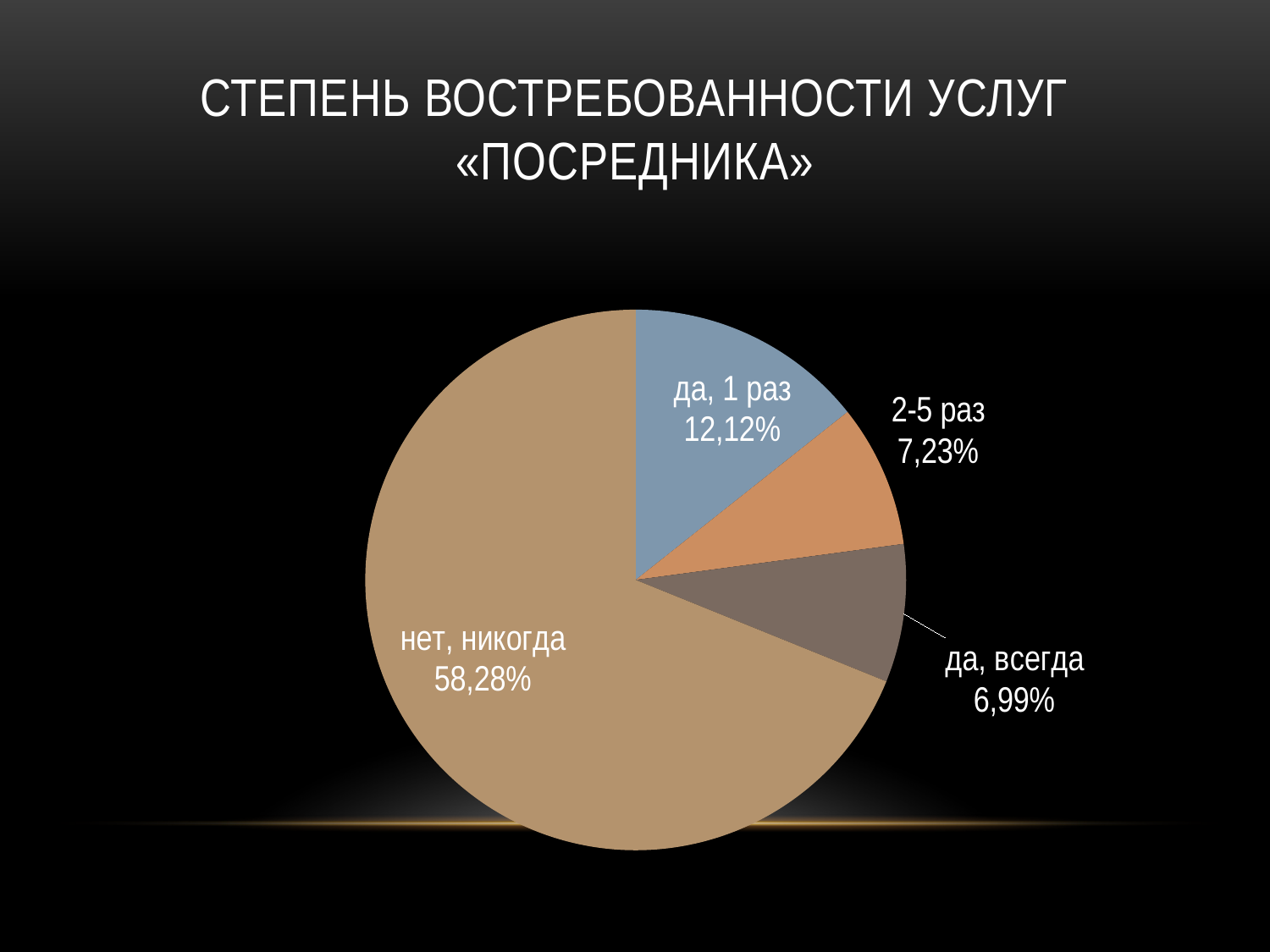
What is the difference between the "нет, никогда" and "да, 1 раз" percentages? 46,16% What percentage is shown for the "нет, никогда" slice? 58,28% How many slices does the pie chart have? 4 What is the title of the slide? СТЕПЕНЬ ВОСТРЕБОВАННОСТИ УСЛУГ «ПОСРЕДНИКА» Which category has the smallest slice of the pie? да, всегда What is the difference between the "да, 1 раз" and "2-5 раз" percentages? 4,89% Which category has the largest slice of the pie? нет, никогда Which is larger, the "2-5 раз" slice or the "да, всегда" slice? 2-5 раз What percentage is shown for the "да, 1 раз" slice? 12,12% What percentage is shown for the "да, всегда" slice? 6,99% What percentage is shown for the "2-5 раз" slice? 7,23% What kind of chart is shown on the slide? pie chart